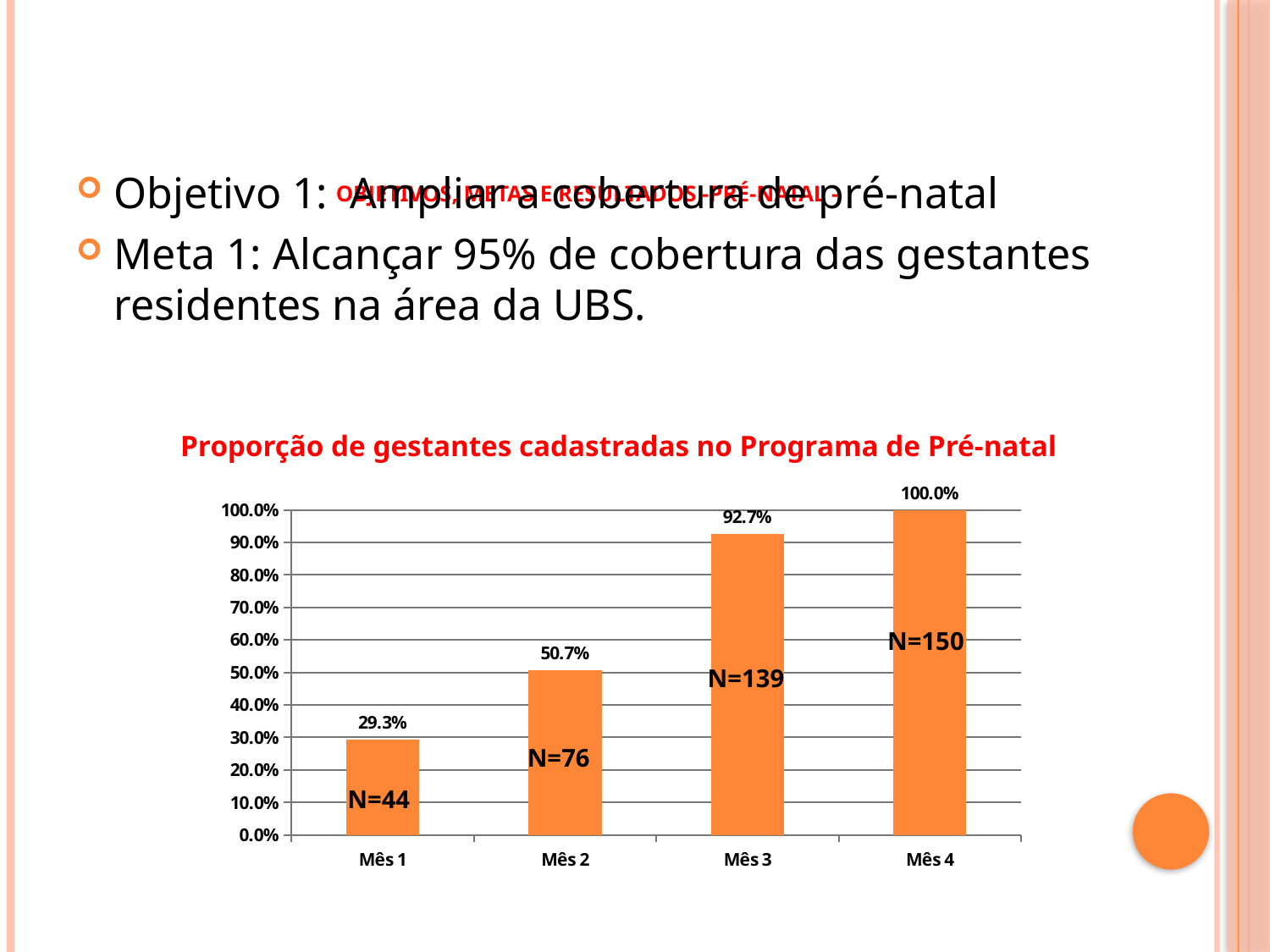
Do the values rise or fall from Mês 1 to Mês 4? rise Which month has the highest proportion? Mês 4 What is the value for Mês 1? 29.3% Which month has the lowest proportion? Mês 1 What is the value for Mês 4? 100.0% What is the difference between the values for Mês 2 and Mês 1? 21.4% What is the title of the chart? Proporção de gestantes cadastradas no Programa de Pré-natal What is the value for Mês 3? 92.7% What kind of chart is shown? bar chart Which is larger, the value for Mês 2 or the value for Mês 3? Mês 3 Is the value for Mês 2 greater or less than 60.0%? less How many months are shown on the x axis? 4